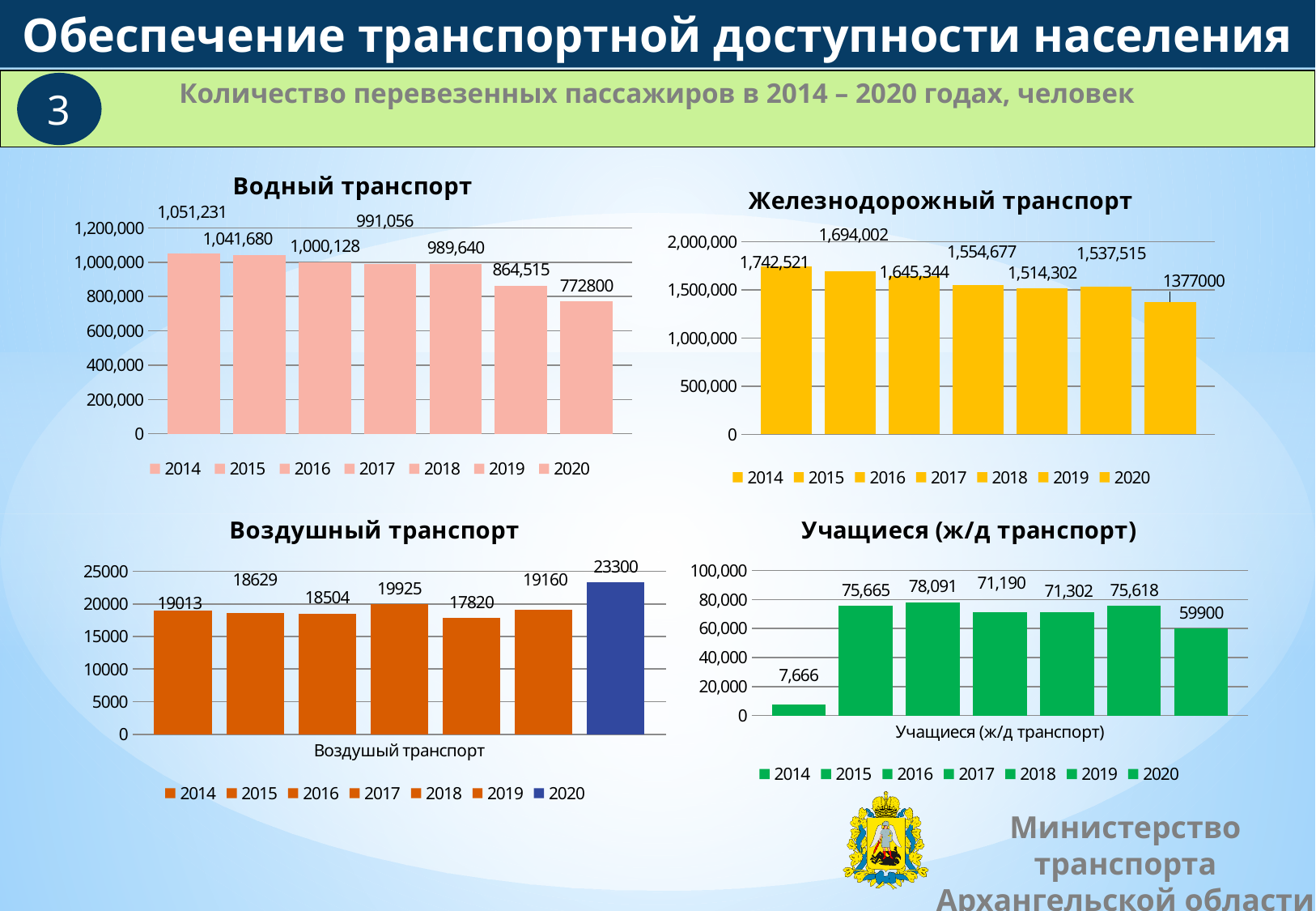
In the "Учащиеся (ж/д транспорт)" chart, what is the value for 2016? 78,091 In the "Железнодорожный транспорт" chart, which year has the highest value? 2014 In the "Учащиеся (ж/д транспорт)" chart, how many years are plotted? 7 In the "Водный транспорт" chart, which year has the lowest value? 2020 In the "Воздушный транспорт" chart, what is the value for 2020? 23300 In the "Водный транспорт" chart, do the values rise or fall from 2014 to 2020? fall In the "Железнодорожный транспорт" chart, what is the difference between the 2014 and 2015 values? 48,519 How many charts are shown on the slide, and what type are they? 4 bar charts In the "Воздушный транспорт" chart, which year has the lowest value? 2018 In the "Воздушный транспорт" chart, which is larger, the value for 2017 or the value for 2019? 2017 In the "Железнодорожный транспорт" chart, what is the value for 2018? 1,514,302 In the "Водный транспорт" chart, what is the value for 2014? 1,051,231